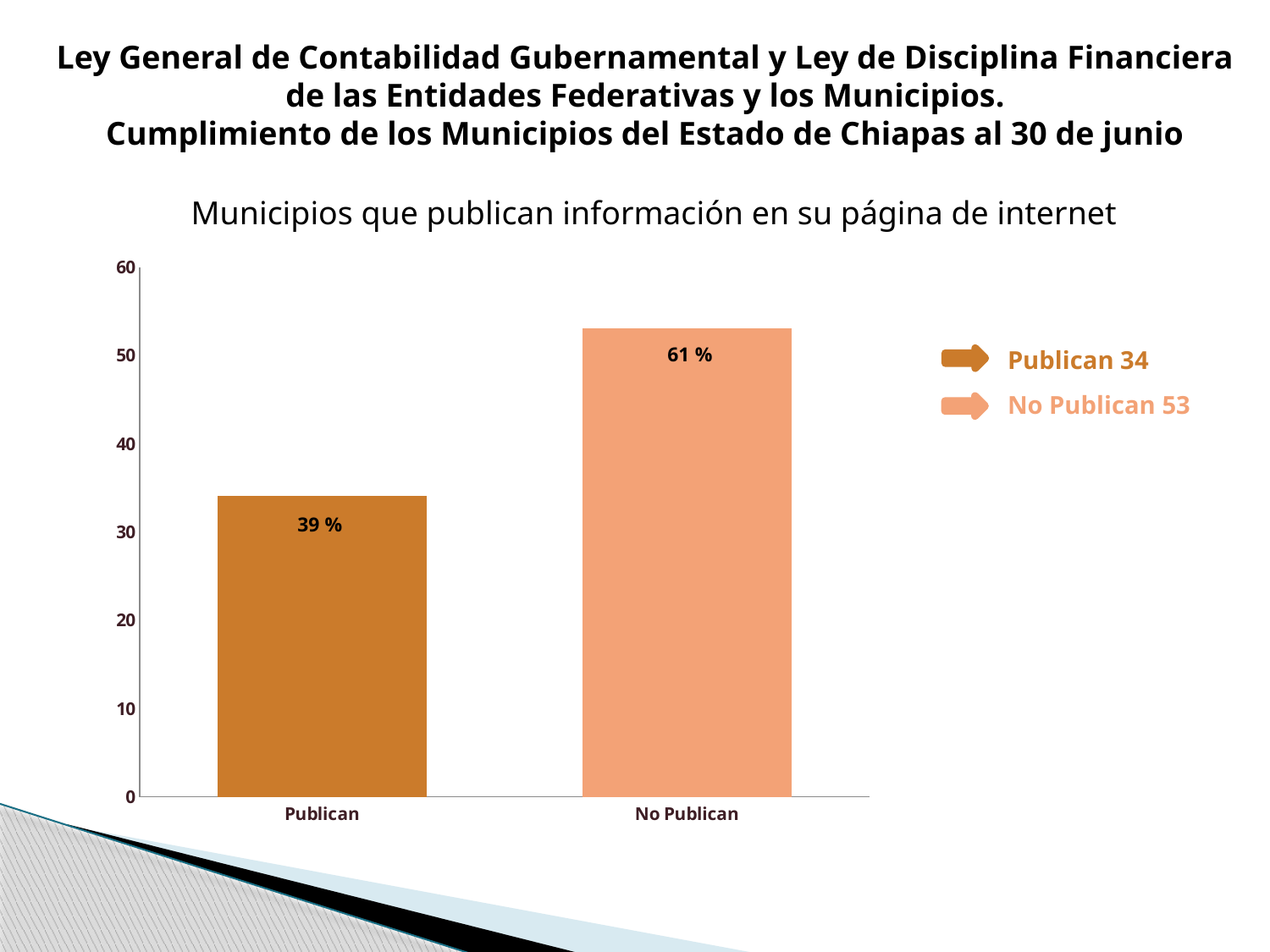
Is the value for Publican greater or less than 40? less Which category has the tallest bar? No Publican Which category has the shortest bar? Publican What percentage label is shown on the Publican bar? 39 % How many categories are shown on the x axis? 2 What kind of chart is shown on the slide? bar chart What percentage label is shown on the No Publican bar? 61 % Is the value for No Publican greater or less than 50? greater What is the difference between the number of municipios that No Publican (53) and those that Publican (34)? 19 According to the legend text on the right, how many municipios are in the Publican group? 34 According to the legend text on the right, how many municipios are in the No Publican group? 53 Which bar is taller, Publican or No Publican? No Publican